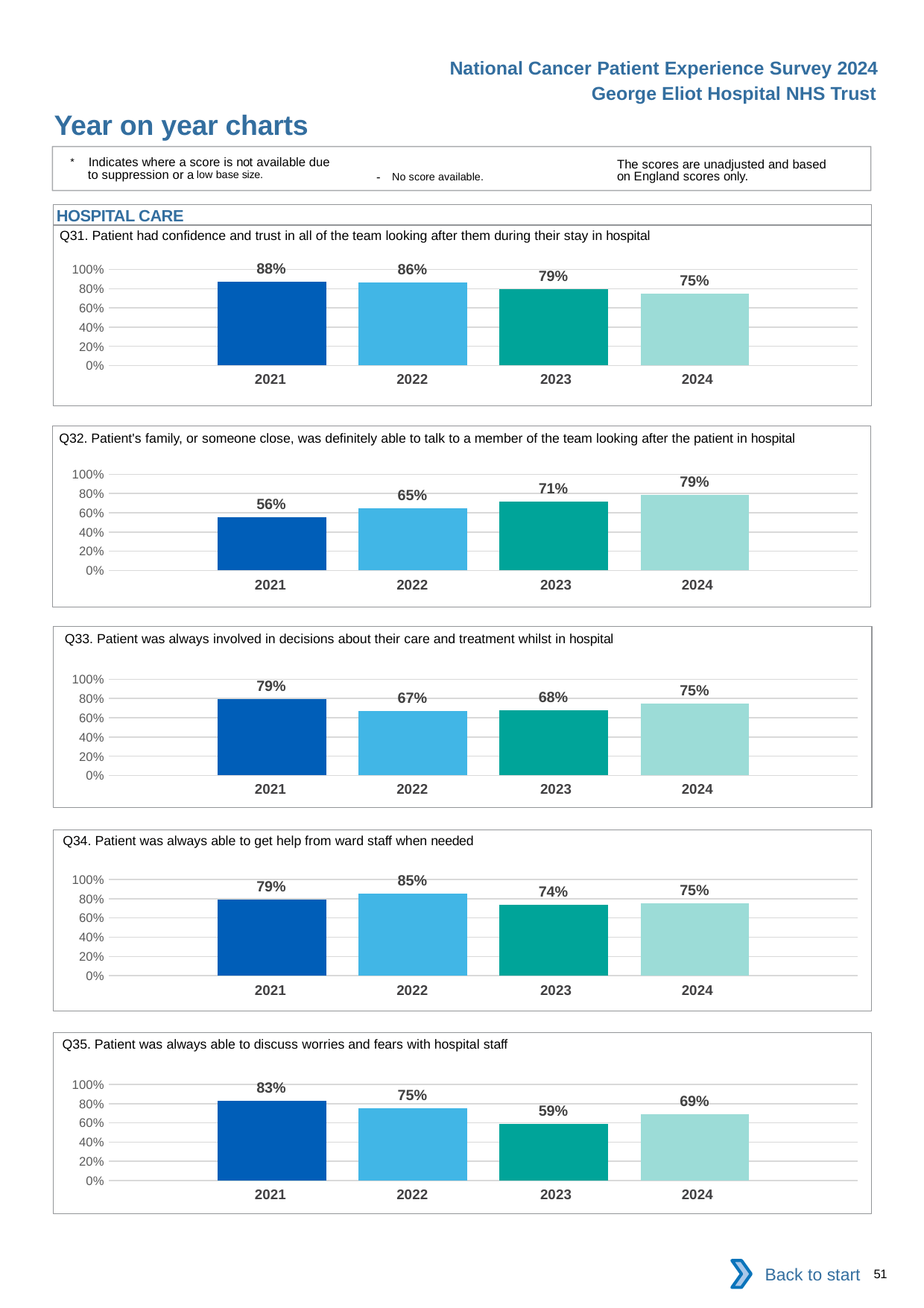
In the Q33 chart, which year has the highest value? 2021 In the Q35 chart, what is the difference between the 2021 and 2022 values? 8 percentage points In the Q32 chart, do the values rise or fall from 2021 to 2024? rise In the Q33 chart, what is the value for 2022? 67% In the Q34 chart, what is the value for 2024? 75% In the Q31 chart, what is the value for 2021? 88% In the Q35 chart, what is the value for 2023? 59% In the Q34 chart, which is larger, the value for 2022 or the value for 2023? 2022 How many years are shown in the Q31 chart? 4 In the Q32 chart, which year has the lowest value? 2021 In the Q32 chart, what is the difference between the 2024 and 2021 values? 23 percentage points What kind of chart is the Q35 chart? bar chart